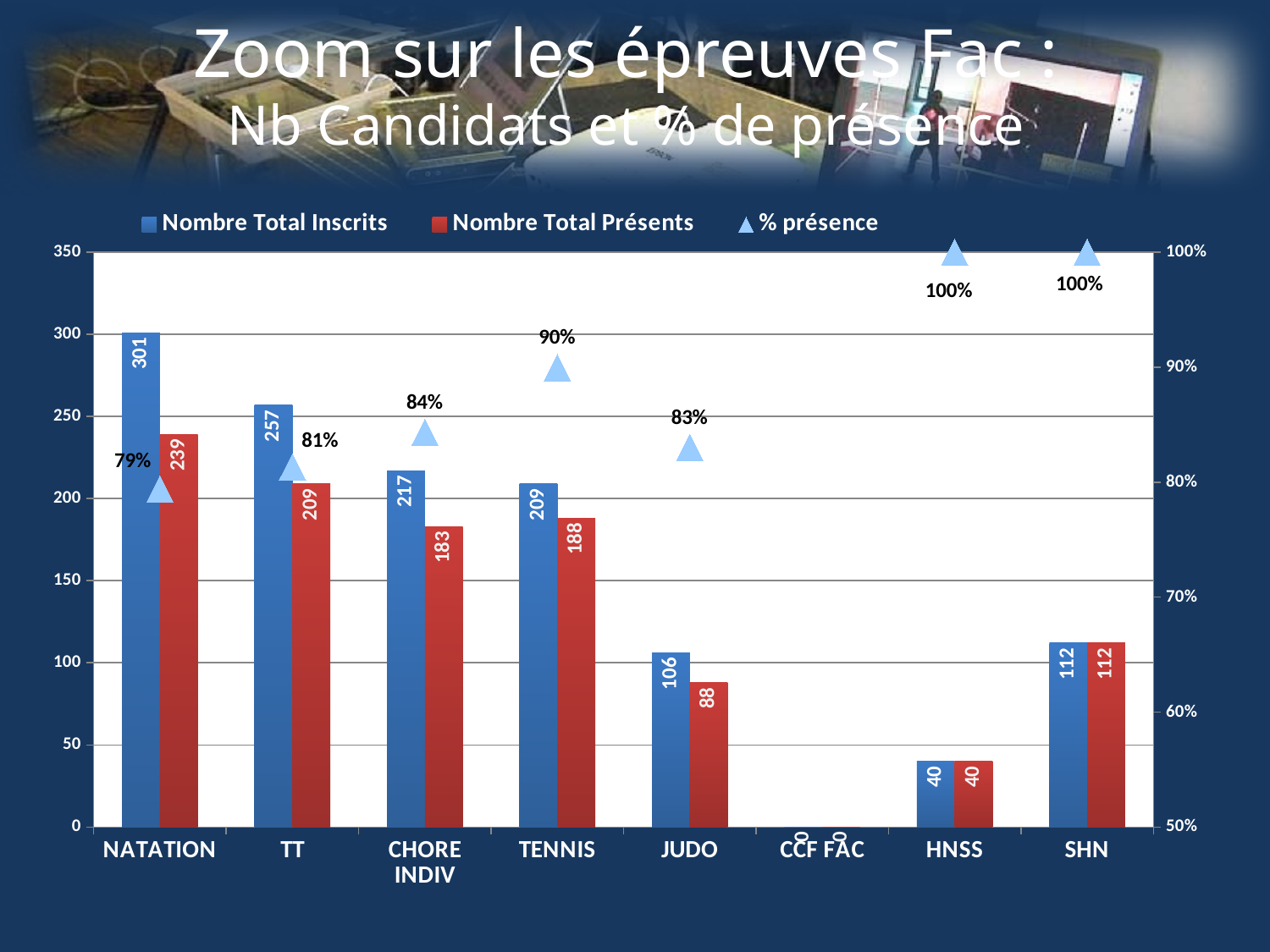
How many series does the legend list? 3 What is the Nombre Total Inscrits value for NATATION? 301 What is the Nombre Total Présents value for TENNIS? 188 What is the % présence value for SHN? 100% What is the Nombre Total Inscrits value for HNSS? 40 Which is larger, the Nombre Total Présents for JUDO or for HNSS? JUDO How many categories are shown on the x axis? 8 What is the difference between Nombre Total Inscrits and Nombre Total Présents for TT? 48 What is the % présence value for CHORE INDIV? 84% Which category has the highest Nombre Total Inscrits? NATATION What is the title of the chart on the slide? Zoom sur les épreuves Fac : Nb Candidats et % de présence